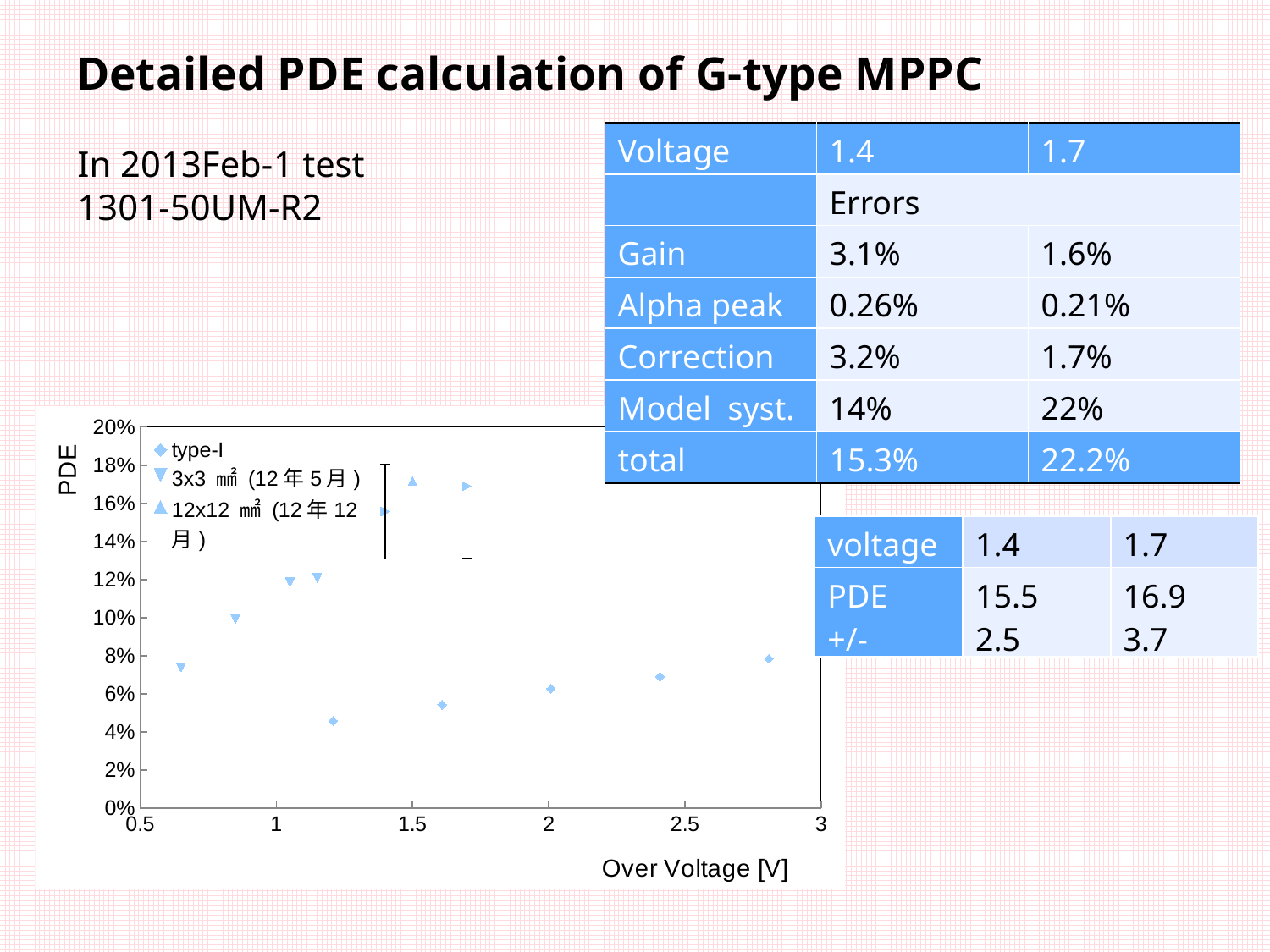
Do the type-I PDE values rise or fall as over voltage increases from about 1.2 V to 2.8 V? rise Which series has the higher PDE values: 12x12 mm² (12年12月) or 3x3 mm² (12年5月)? 12x12 mm² (12年12月) Is the PDE value of the 12x12 mm² (12年12月) point greater or less than 16%? greater What is the label of the x axis of the chart? Over Voltage [V] How many series does the chart legend list? 3 Do the PDE values of the 3x3 mm² (12年5月) series rise or fall as over voltage increases? rise How many data points are plotted for the 12x12 mm² (12年12月) series? 1 How many data points are plotted for the 3x3 mm² (12年5月) series? 4 Is the PDE value of the 3x3 mm² (12年5月) point at an over voltage of about 0.85 V greater or less than 8%? greater Is the PDE value of the type-I point at an over voltage of about 2.8 V greater or less than 10%? less What kind of chart is shown on the slide? scatter chart What is the label of the y axis of the chart? PDE